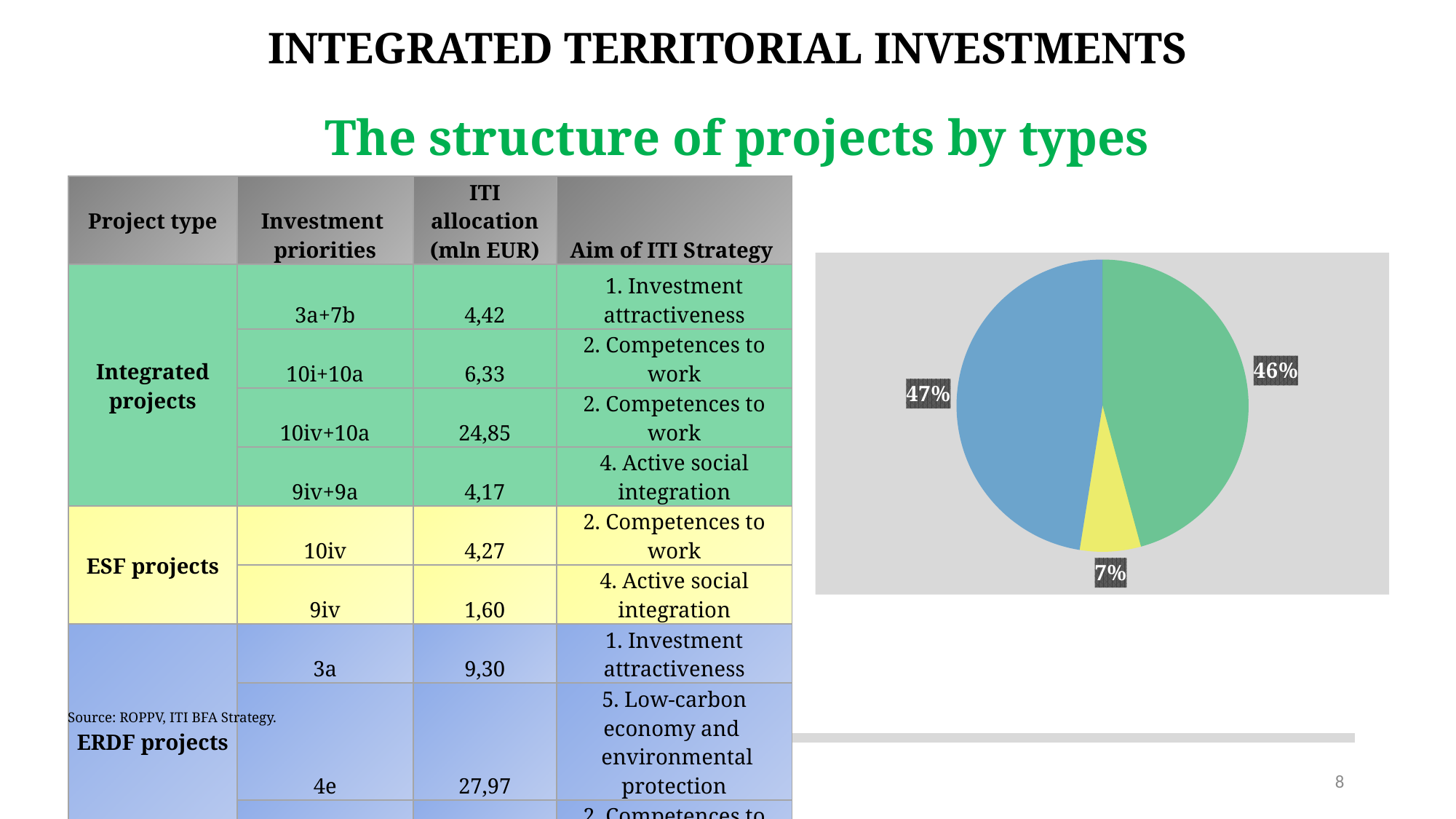
What is the difference in percentage points between the green slice and the yellow slice? 39 percentage points What percentage is shown for the blue slice of the pie chart? 47% Which slice of the pie chart has the largest share according to the data labels? the blue slice (47%) How many slices does the pie chart have? 3 What is the difference in percentage points between the blue slice and the green slice? 1 percentage point What percentage is shown for the yellow slice of the pie chart? 7% What colours are used for the three slices of the pie chart? green, blue and yellow What is the combined share of the green and blue slices of the pie chart? 93% What kind of chart is shown on the right of the slide? pie chart What percentage is shown for the green slice of the pie chart? 46% Which slice of the pie chart is the smallest? the yellow slice (7%) Is the share of the blue slice larger or smaller than the share of the yellow slice? larger